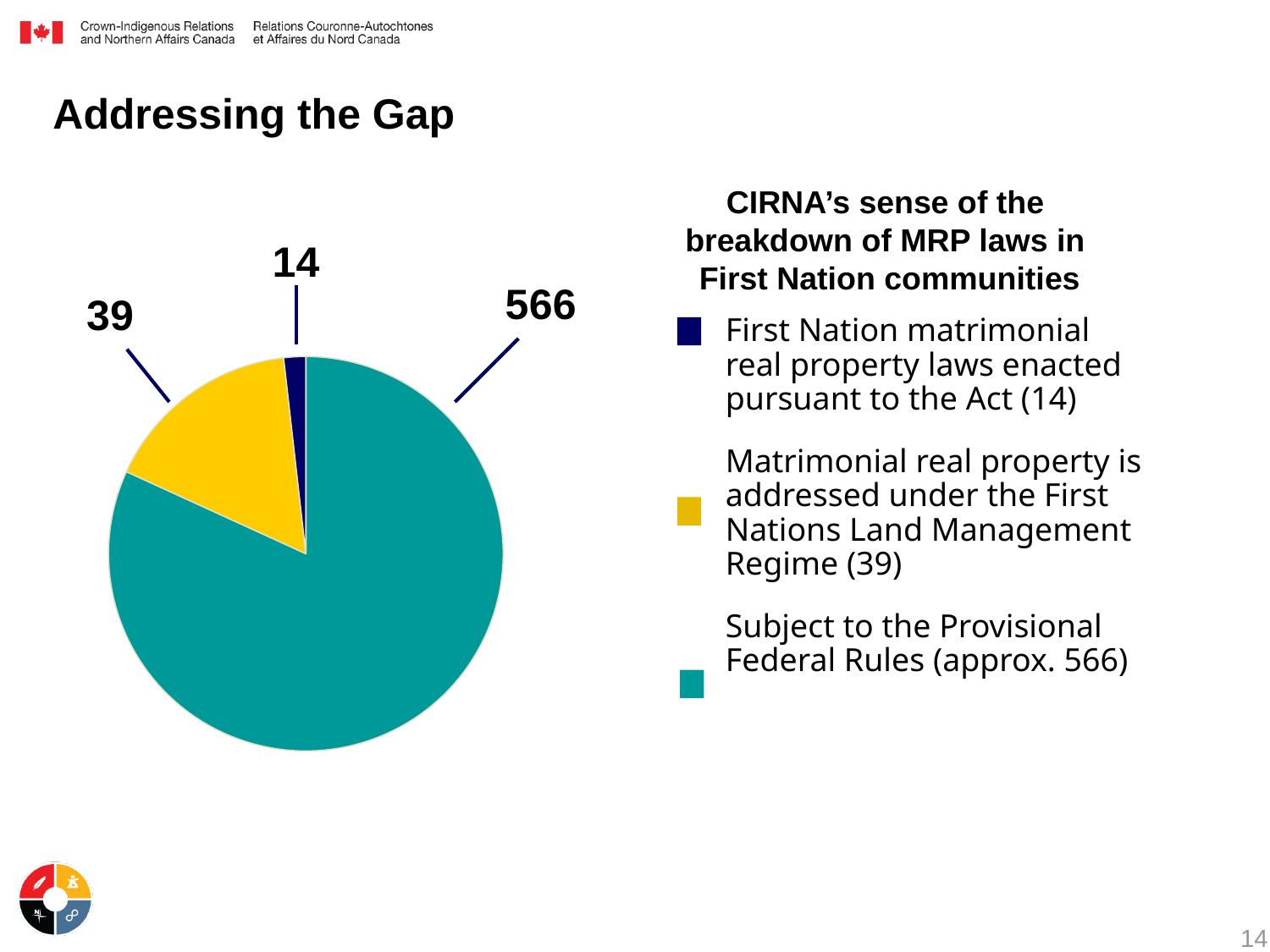
How many entries does the legend of the pie chart list? 3 How many slices does the pie chart have? 3 What type of chart is shown on the slide? pie chart What is the total of all three values shown on the pie chart? 619 Which category has the smallest slice in the pie chart? First Nation matrimonial real property laws enacted pursuant to the Act What is the difference between the value for the Provisional Federal Rules slice and the First Nations Land Management Regime slice? 527 What is the value of the slice for First Nation matrimonial real property laws enacted pursuant to the Act? 14 What is the value of the slice for matrimonial real property addressed under the First Nations Land Management Regime? 39 What colour is the slice representing communities subject to the Provisional Federal Rules? teal Which is larger: the slice for the First Nations Land Management Regime or the slice for laws enacted pursuant to the Act? First Nations Land Management Regime What is the value of the slice for communities subject to the Provisional Federal Rules? 566 Which category has the largest slice in the pie chart? Subject to the Provisional Federal Rules